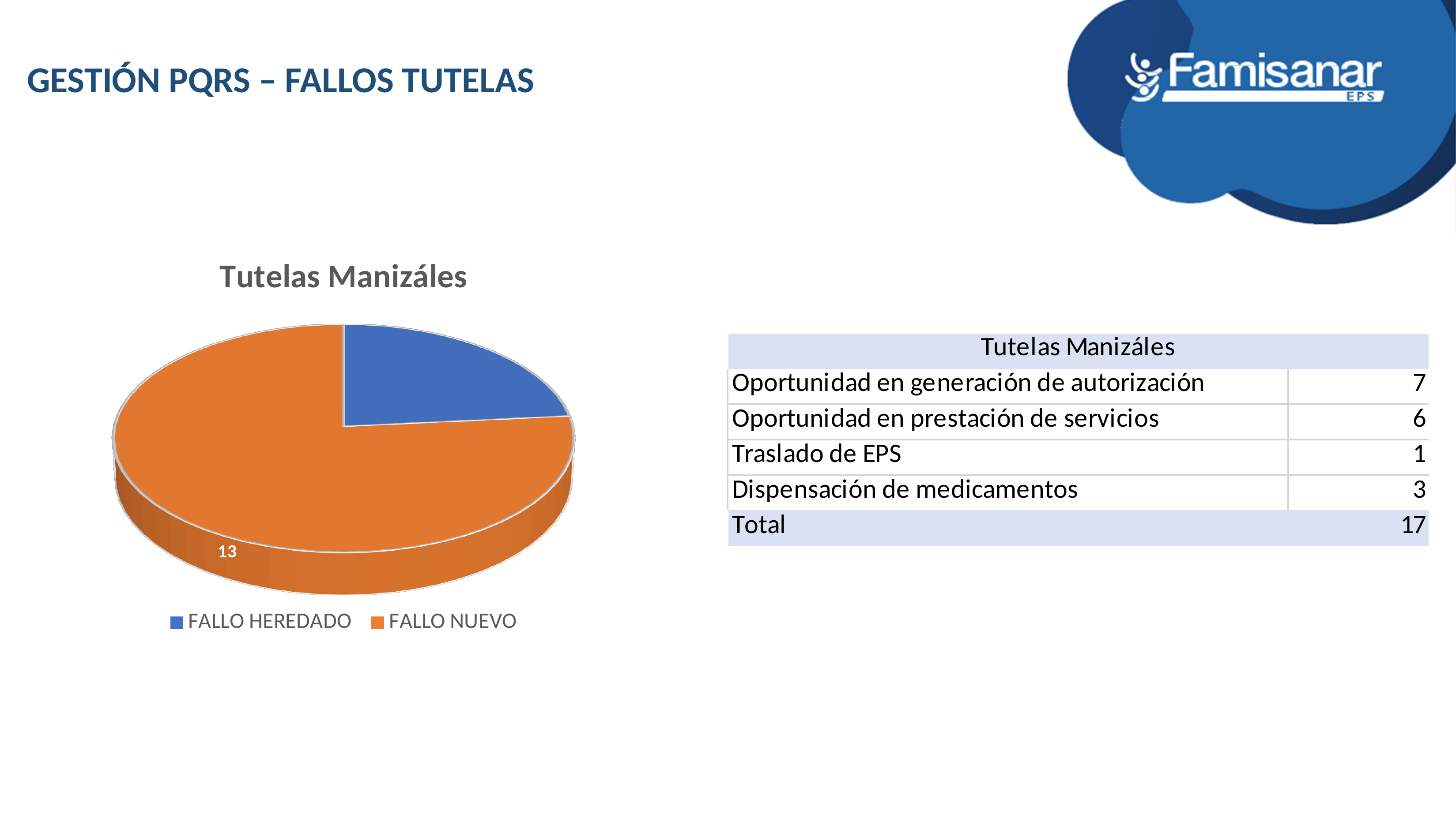
Which slice of the pie chart is the largest? FALLO NUEVO How many slices does the pie chart have? 2 How many entries does the legend of the pie chart list? 2 What kind of chart is shown on the slide? pie chart What is the value shown for FALLO NUEVO in the pie chart? 13 What colour is the FALLO NUEVO slice in the pie chart? orange Which is larger in the pie chart, FALLO HEREDADO or FALLO NUEVO? FALLO NUEVO What is the title of the pie chart? Tutelas Manizáles Which slice of the pie chart is the smallest? FALLO HEREDADO